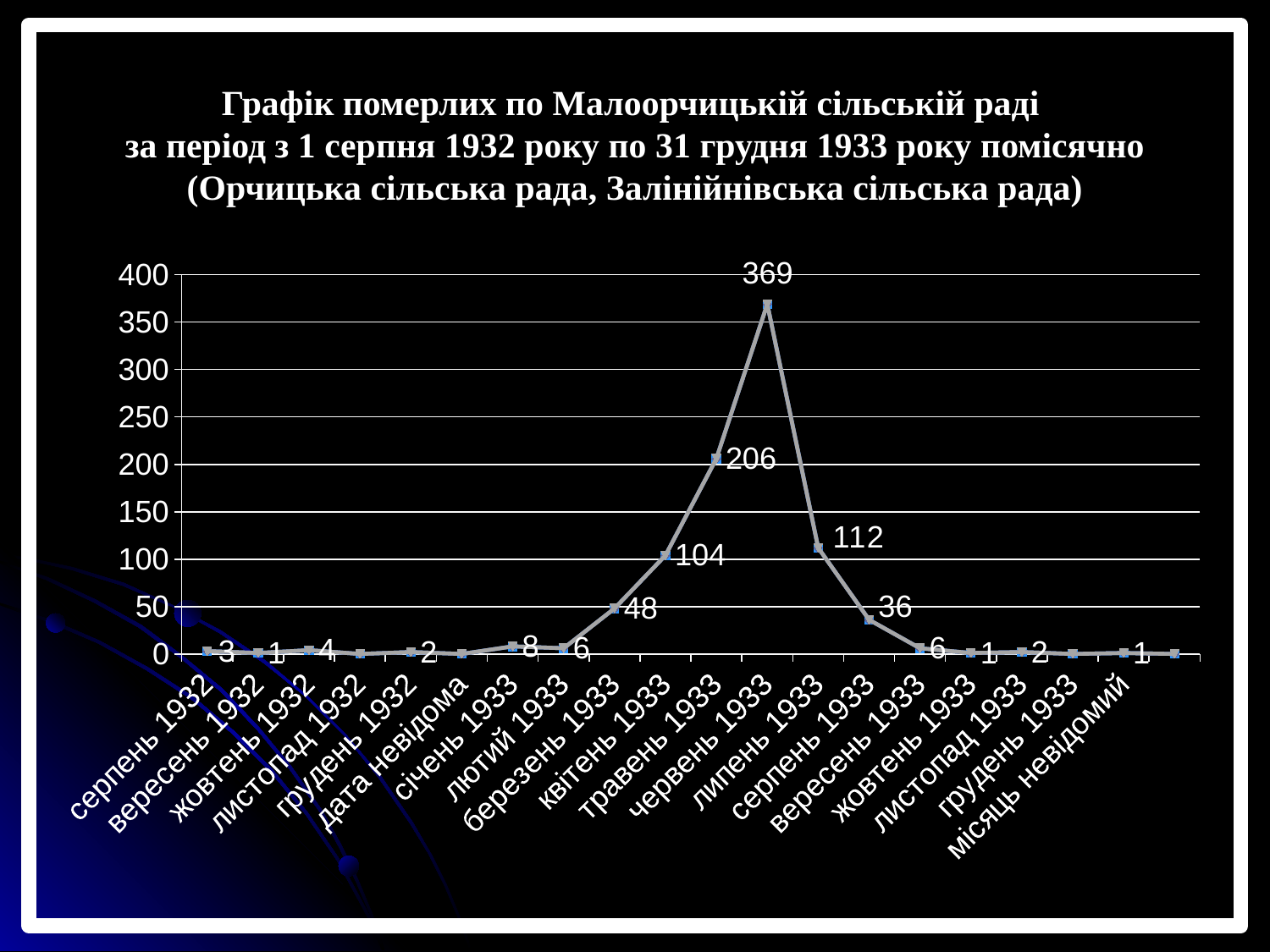
What type of chart is shown on the slide? line chart What is the value for березень 1933? 48 What is the value for квітень 1933? 104 What is the value for травень 1933? 206 Which month has the highest number of deaths? червень 1933 What is the value for червень 1933? 369 Do the values rise or fall from березень 1933 to червень 1933? rise Which is larger, the value for липень 1933 or the value for квітень 1933? липень 1933 What is the value for липень 1933? 112 What is the difference between the values for червень 1933 and травень 1933? 163 How many categories are shown on the x axis? 19 Is the value for серпень 1933 greater or less than 50? less